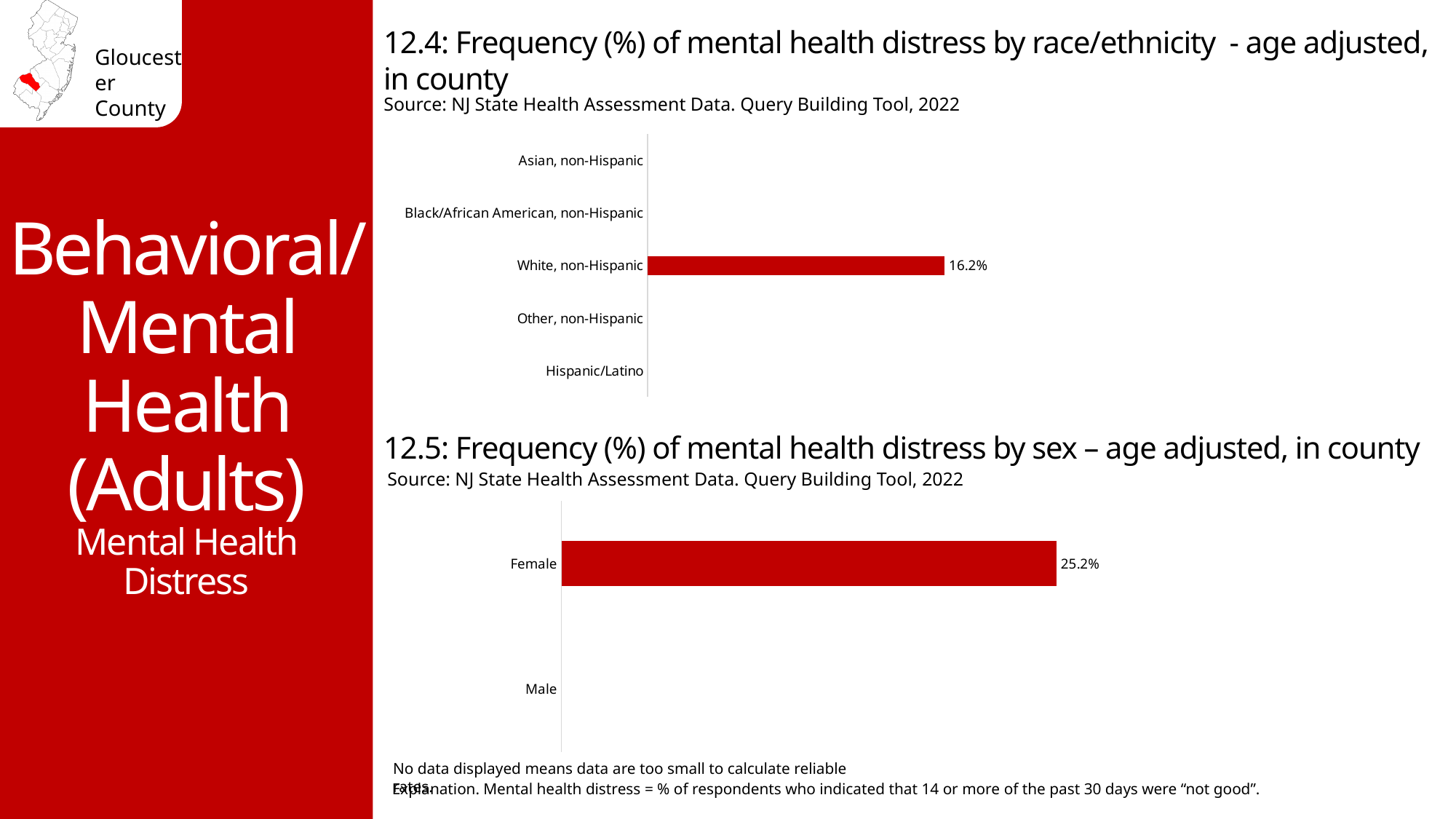
In chart 12.4 (mental health distress by race/ethnicity), how many race/ethnicity categories are listed on the axis? 5 What kind of chart is chart 12.5 (mental health distress by sex)? Bar chart In chart 12.4 (mental health distress by race/ethnicity), what is the value for White, non-Hispanic? 16.2% In chart 12.5 (mental health distress by sex), how many categories are listed on the axis? 2 In chart 12.5 (mental health distress by sex), what is the value for Female? 25.2% Which is larger: the value for White, non-Hispanic in chart 12.4 or the value for Female in chart 12.5? Female in chart 12.5 In chart 12.5 (mental health distress by sex), which category has no bar displayed? Male What is the difference between the Female value in chart 12.5 and the White, non-Hispanic value in chart 12.4? 9.0% In chart 12.4 (mental health distress by race/ethnicity), which category is the only one with a bar displayed? White, non-Hispanic What kind of chart is chart 12.4 (mental health distress by race/ethnicity)? Bar chart